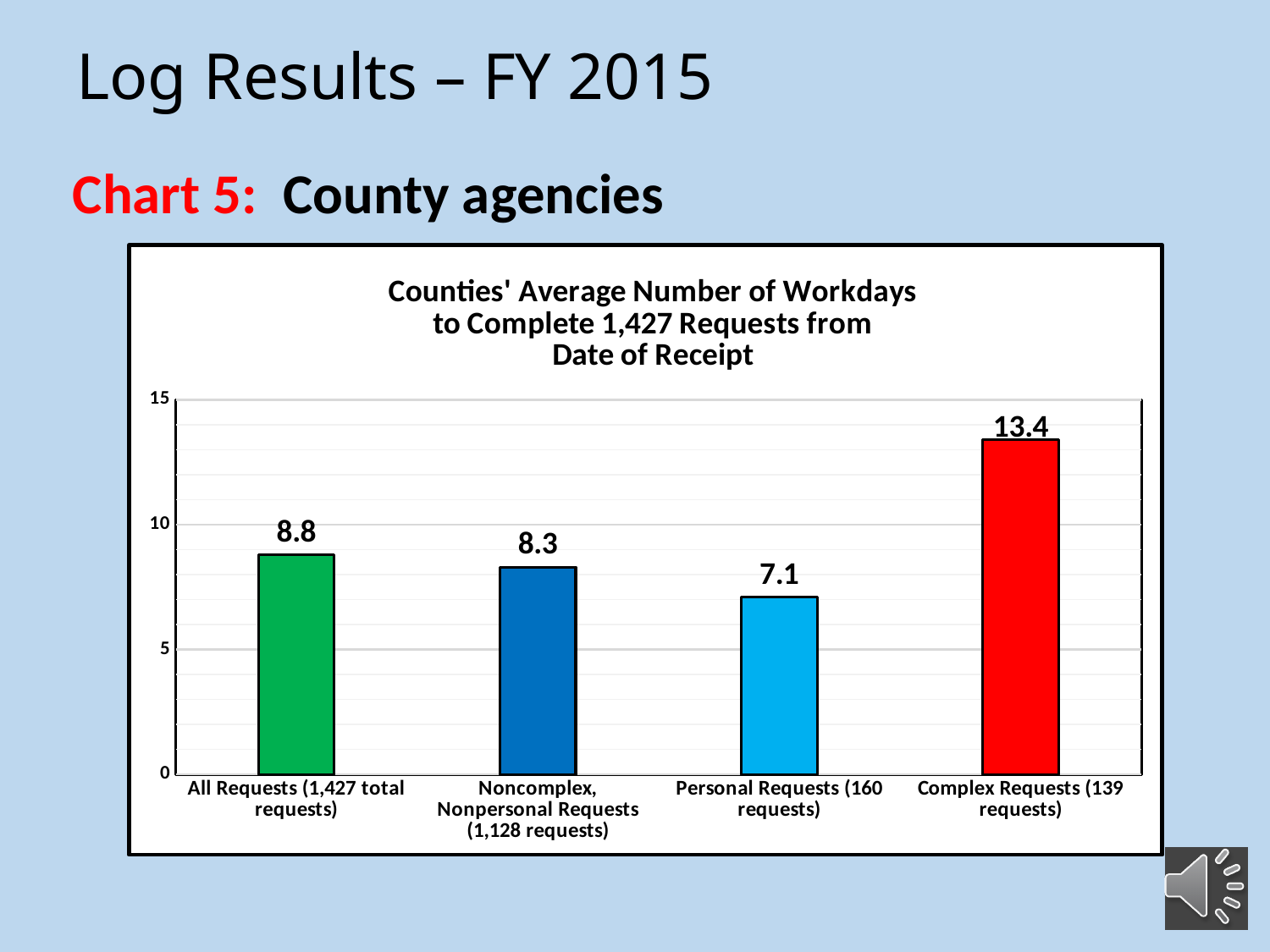
What is the average number of workdays for Complex Requests (139 requests)? 13.4 What is the title of the chart? Counties' Average Number of Workdays to Complete 1,427 Requests from Date of Receipt What is the average number of workdays for All Requests (1,427 total requests)? 8.8 What is the average number of workdays for Personal Requests (160 requests)? 7.1 How many categories are shown in the chart? 4 What is the difference in average workdays between Complex Requests and Personal Requests? 6.3 Is the value for Complex Requests greater or less than 10? greater What kind of chart is shown on the slide? Bar chart What is the average number of workdays for Noncomplex, Nonpersonal Requests (1,128 requests)? 8.3 Which category has the highest average number of workdays? Complex Requests (139 requests) Which has a higher average number of workdays, All Requests or Noncomplex, Nonpersonal Requests? All Requests (1,427 total requests) Which category has the lowest average number of workdays? Personal Requests (160 requests)